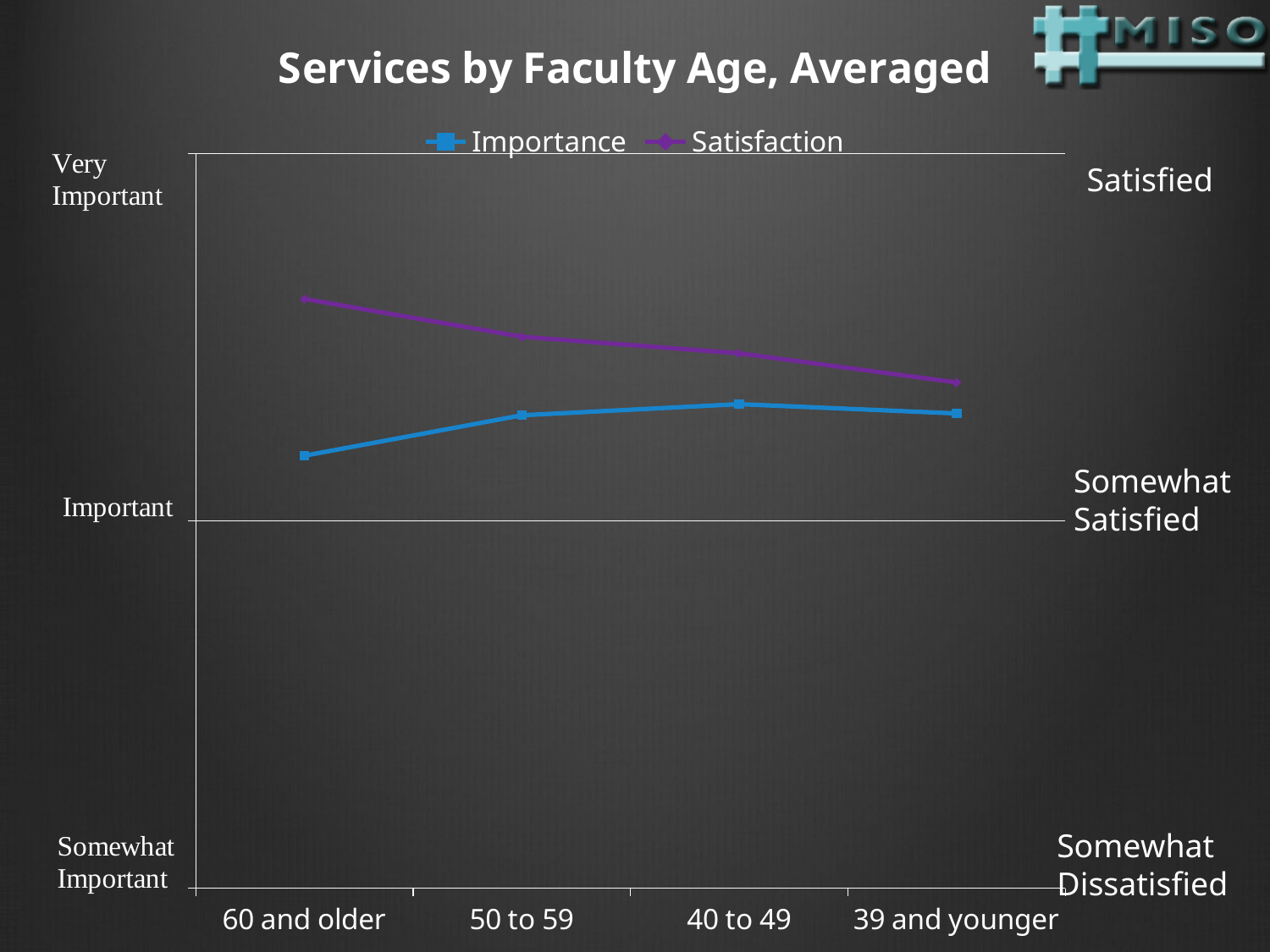
Which series is drawn in purple? Satisfaction How many series does the legend list? 2 Does the Importance line rise or fall from 60 and older to 50 to 59? rise For the 60 and older group, which is plotted higher, Importance or Satisfaction? Satisfaction Does the Satisfaction line rise or fall from 60 and older to 39 and younger? fall For which age group is Satisfaction highest? 60 and older Is Satisfaction for 60 and older higher or lower than Satisfaction for 39 and younger? higher For which age group is Importance lowest? 60 and older How many faculty age categories are shown on the x axis? 4 For which age group is Satisfaction lowest? 39 and younger What is the title of the chart? Services by Faculty Age, Averaged What kind of chart is shown on the slide? line chart